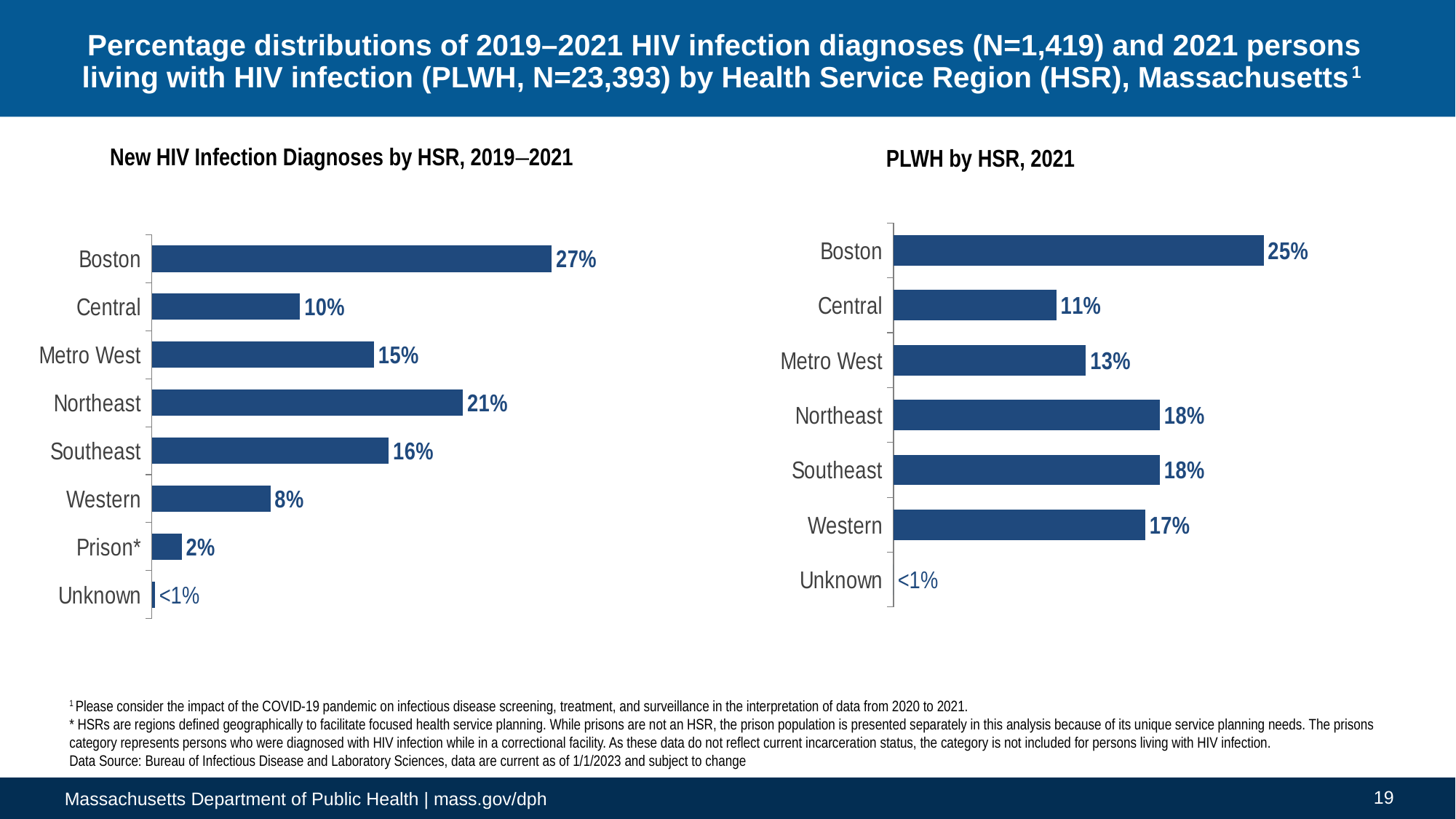
In the 'PLWH by HSR, 2021' chart, which is larger, the value for Central or the value for Western? Western In the 'New HIV Infection Diagnoses by HSR, 2019–2021' chart, what is the value for Prison*? 2% How many categories are shown in the 'New HIV Infection Diagnoses by HSR, 2019–2021' chart? 8 In the 'PLWH by HSR, 2021' chart, which region has the highest value? Boston In the 'PLWH by HSR, 2021' chart, what is the value for Western? 17% In the 'New HIV Infection Diagnoses by HSR, 2019–2021' chart, which category has the lowest value? Unknown In the 'New HIV Infection Diagnoses by HSR, 2019–2021' chart, what is the value for Boston? 27% In the 'New HIV Infection Diagnoses by HSR, 2019–2021' chart, what is the difference between the values for Northeast and Central? 11% In the 'New HIV Infection Diagnoses by HSR, 2019–2021' chart, which is larger, the value for Southeast or the value for Metro West? Southeast In the 'PLWH by HSR, 2021' chart, what is the difference between the values for Boston and Metro West? 12% What type of chart is the 'PLWH by HSR, 2021' chart? Bar chart How many categories are shown in the 'PLWH by HSR, 2021' chart? 7